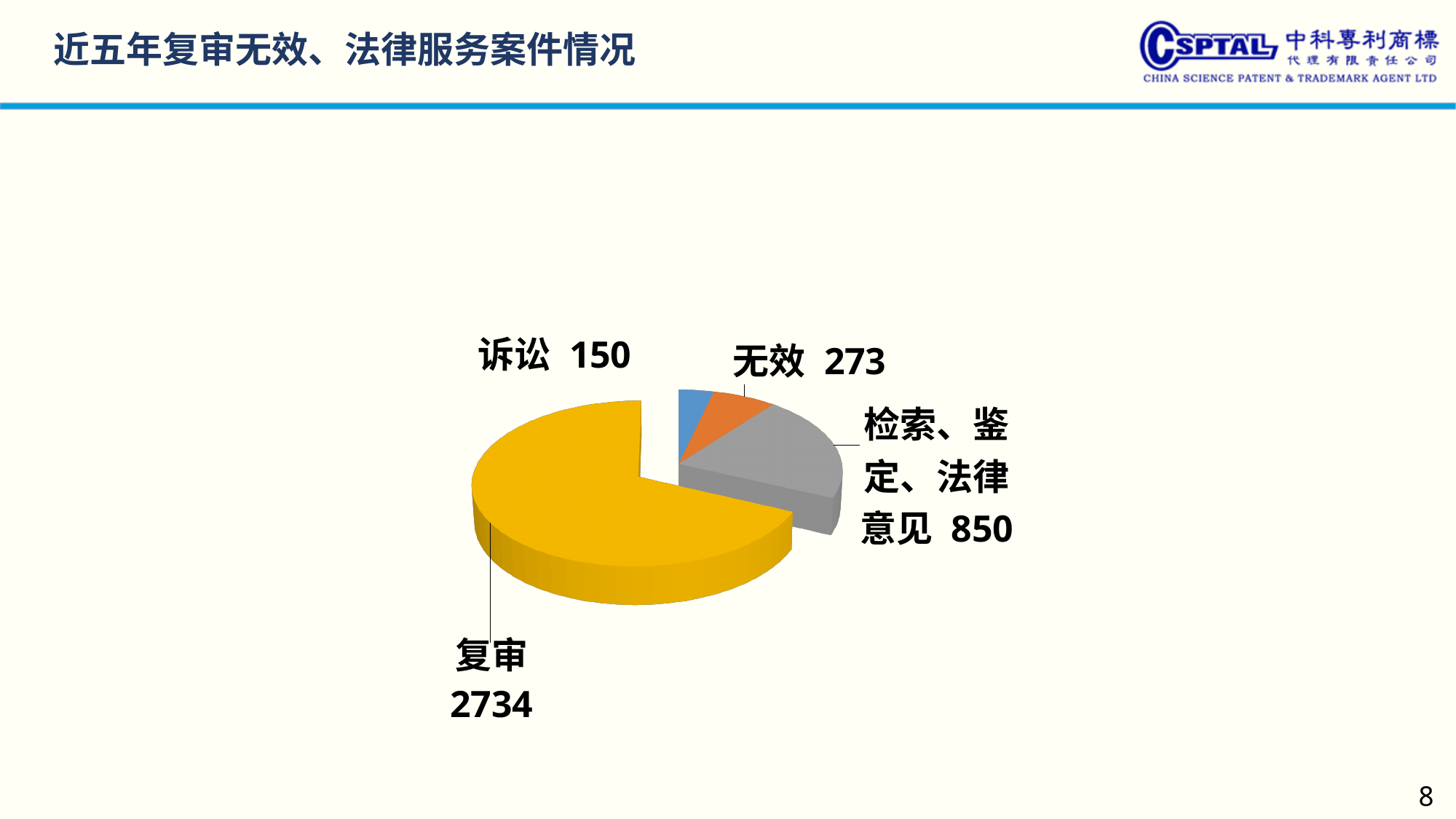
Which is larger, the value for 无效 or the value for 诉讼? 无效 What is the difference between the values for 复审 and 检索、鉴定、法律意见? 1884 What is the value for 复审 in the pie chart? 2734 What is the value for 无效 in the pie chart? 273 What is the value for 检索、鉴定、法律意见 in the pie chart? 850 What is the value for 诉讼 in the pie chart? 150 Which category has the smallest slice in the pie chart? 诉讼 What is the total of all four values in the pie chart? 4007 How many categories are shown in the pie chart? 4 What kind of chart is shown on the slide? Pie chart Which category has the largest slice in the pie chart? 复审 What is the difference between the values for 无效 and 诉讼? 123